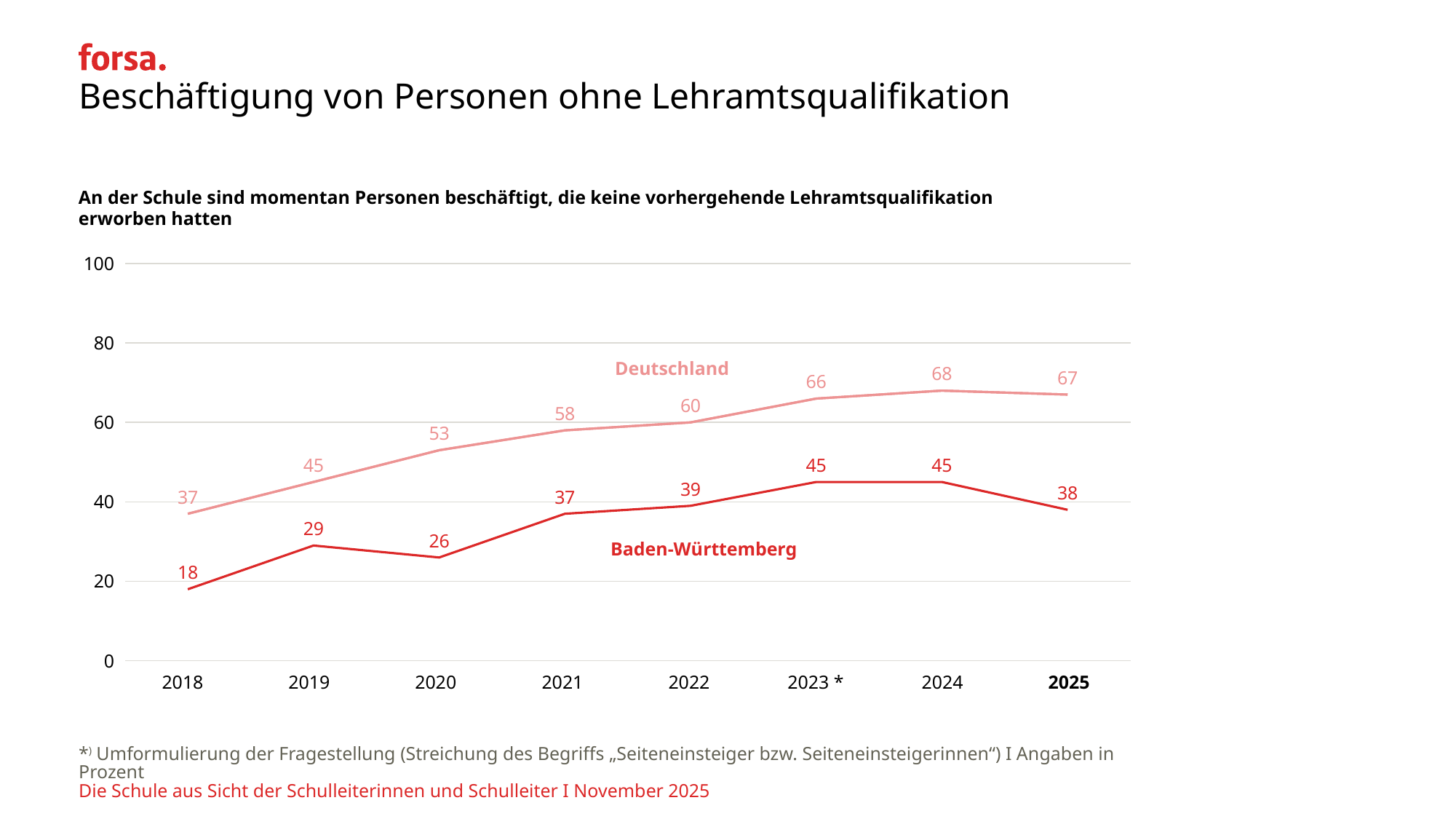
What kind of chart is shown on the slide? Line chart What is the value for Baden-Württemberg in 2025? 38 Does the Deutschland line rise or fall from 2018 to 2024? Rise Which is larger in 2022: the value for Deutschland or for Baden-Württemberg? Deutschland How many series are plotted in the chart? 2 What is the value for Deutschland in 2020? 53 What is the difference between the Deutschland and Baden-Württemberg values in 2025? 29 In which year is the Deutschland value highest? 2024 How many years are shown on the x axis? 8 In which year is the Baden-Württemberg value lowest? 2018 Is the value for Deutschland in 2019 greater or less than 40? greater What is the value for Baden-Württemberg in 2018? 18